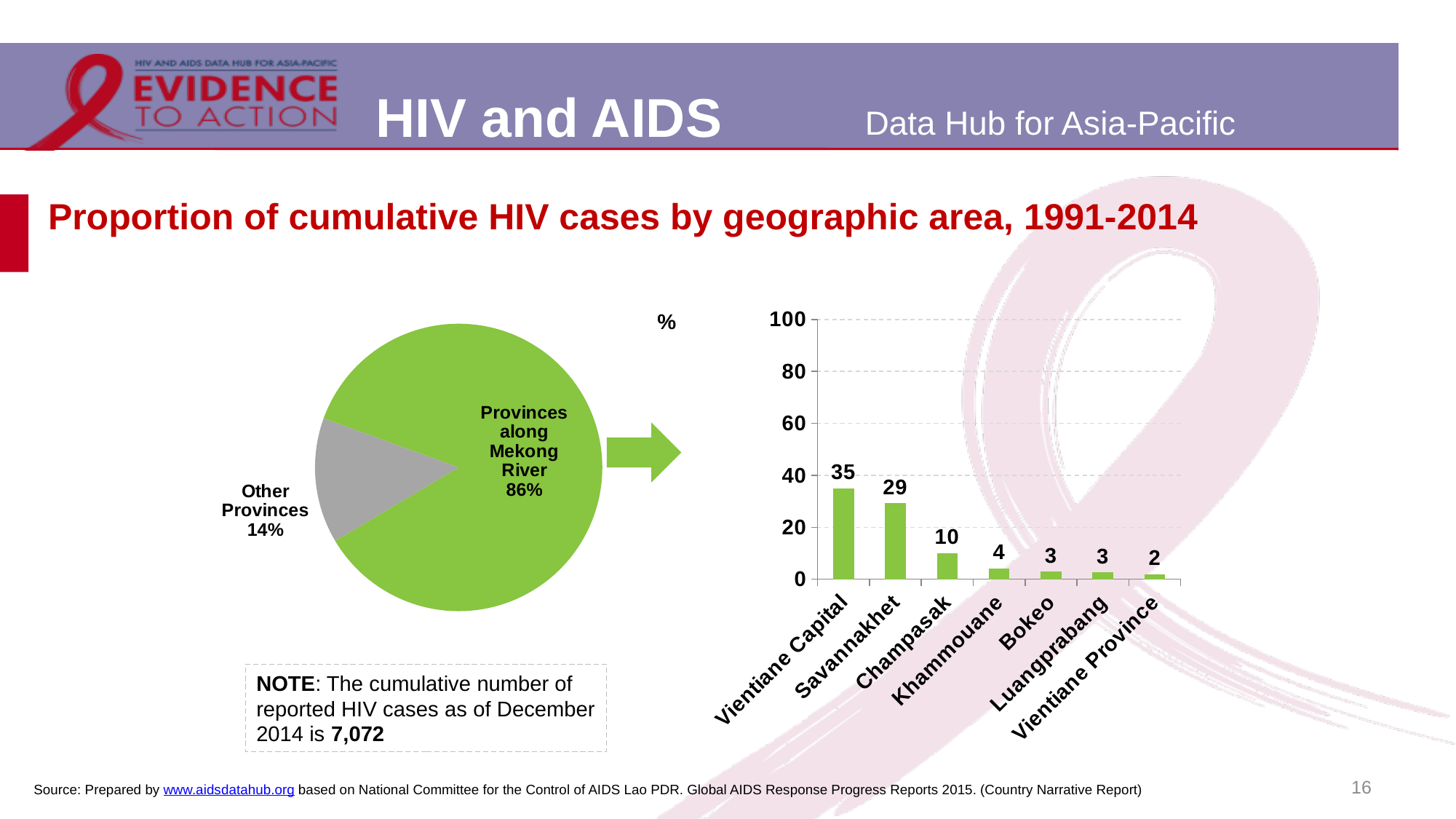
In the bar chart on the right, what is the value for Champasak? 10 In the bar chart on the right, what is the value for Vientiane Capital? 35 In the pie chart on the left, what share of cumulative HIV cases is from Provinces along Mekong River? 86% In the bar chart on the right, which is larger, the value for Khammouane or the value for Champasak? Champasak What kind of chart is the chart on the right of the slide? Bar chart In the bar chart on the right, what is the difference between the values for Vientiane Capital and Savannakhet? 6 In the bar chart on the right, do the values rise or fall from left to right along the x axis? Fall What kind of chart is the chart on the left of the slide? Pie chart In the pie chart on the left, what share of cumulative HIV cases is from Other Provinces? 14% How many provinces are shown in the bar chart on the right? 7 In the bar chart on the right, which province has the highest value? Vientiane Capital In the bar chart on the right, which province has the lowest value? Vientiane Province